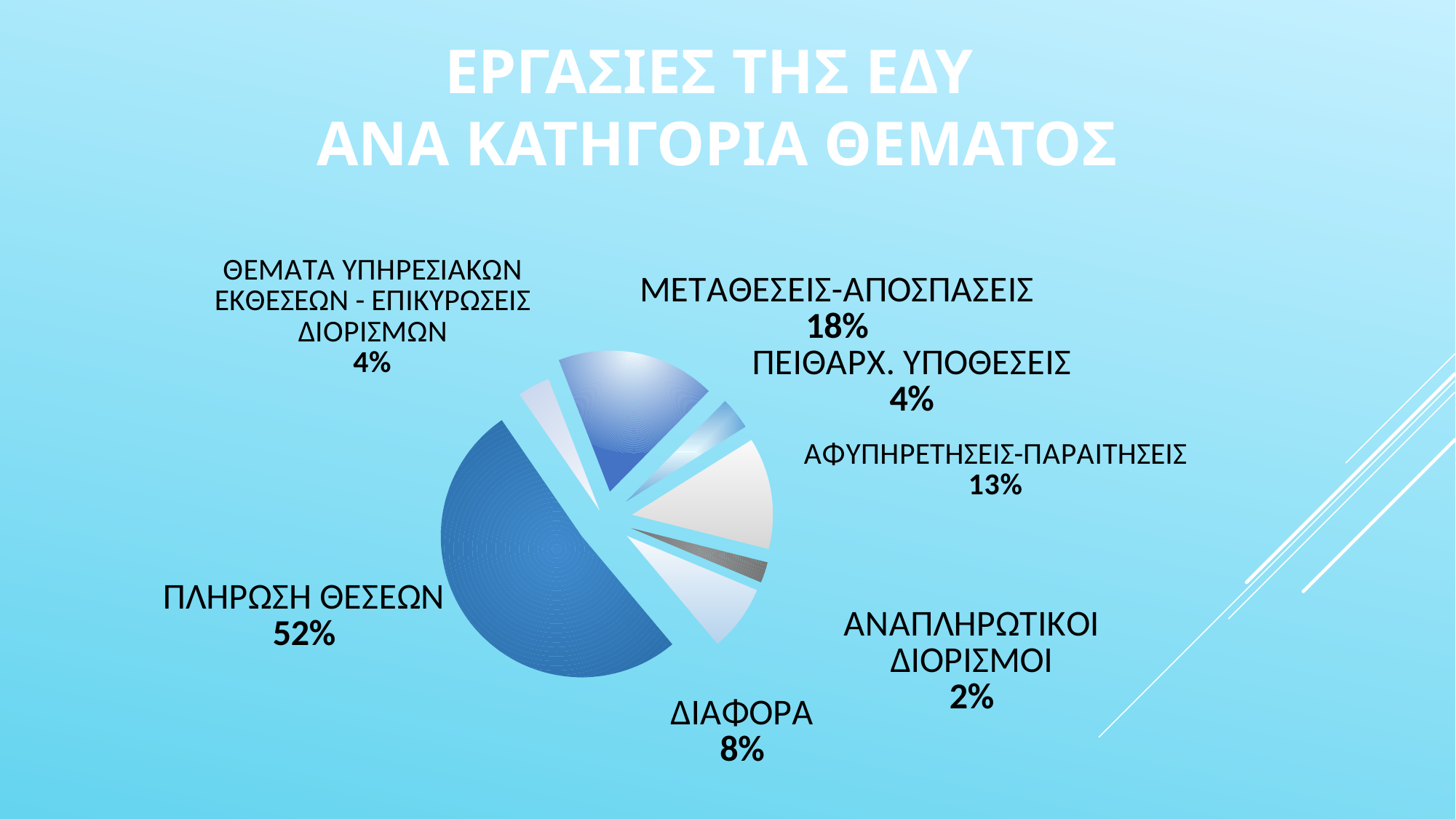
Which category has the largest share of the pie? ΠΛΗΡΩΣΗ ΘΕΣΕΩΝ What is the value shown for ΘΕΜΑΤΑ ΥΠΗΡΕΣΙΑΚΩΝ ΕΚΘΕΣΕΩΝ - ΕΠΙΚΥΡΩΣΕΙΣ ΔΙΟΡΙΣΜΩΝ? 4% How many categories (slices) does the pie chart have? 7 What is the value shown for ΔΙΑΦΟΡΑ? 8% What is the difference in percentage points between ΜΕΤΑΘΕΣΕΙΣ-ΑΠΟΣΠΑΣΕΙΣ and ΑΦΥΠΗΡΕΤΗΣΕΙΣ-ΠΑΡΑΙΤΗΣΕΙΣ? 5% What share of the pie does ΠΛΗΡΩΣΗ ΘΕΣΕΩΝ represent? 52% What is the value shown for ΜΕΤΑΘΕΣΕΙΣ-ΑΠΟΣΠΑΣΕΙΣ? 18% What is the value shown for ΑΦΥΠΗΡΕΤΗΣΕΙΣ-ΠΑΡΑΙΤΗΣΕΙΣ? 13% What is the title of the chart? ΕΡΓΑΣΙΕΣ ΤΗΣ ΕΔΥ ΑΝΑ ΚΑΤΗΓΟΡΙΑ ΘΕΜΑΤΟΣ What type of chart is shown on the slide? Pie chart Which category has the smallest share of the pie? ΑΝΑΠΛΗΡΩΤΙΚΟΙ ΔΙΟΡΙΣΜΟΙ Which is larger, the share for ΔΙΑΦΟΡΑ or the share for ΠΕΙΘΑΡΧ. ΥΠΟΘΕΣΕΙΣ? ΔΙΑΦΟΡΑ